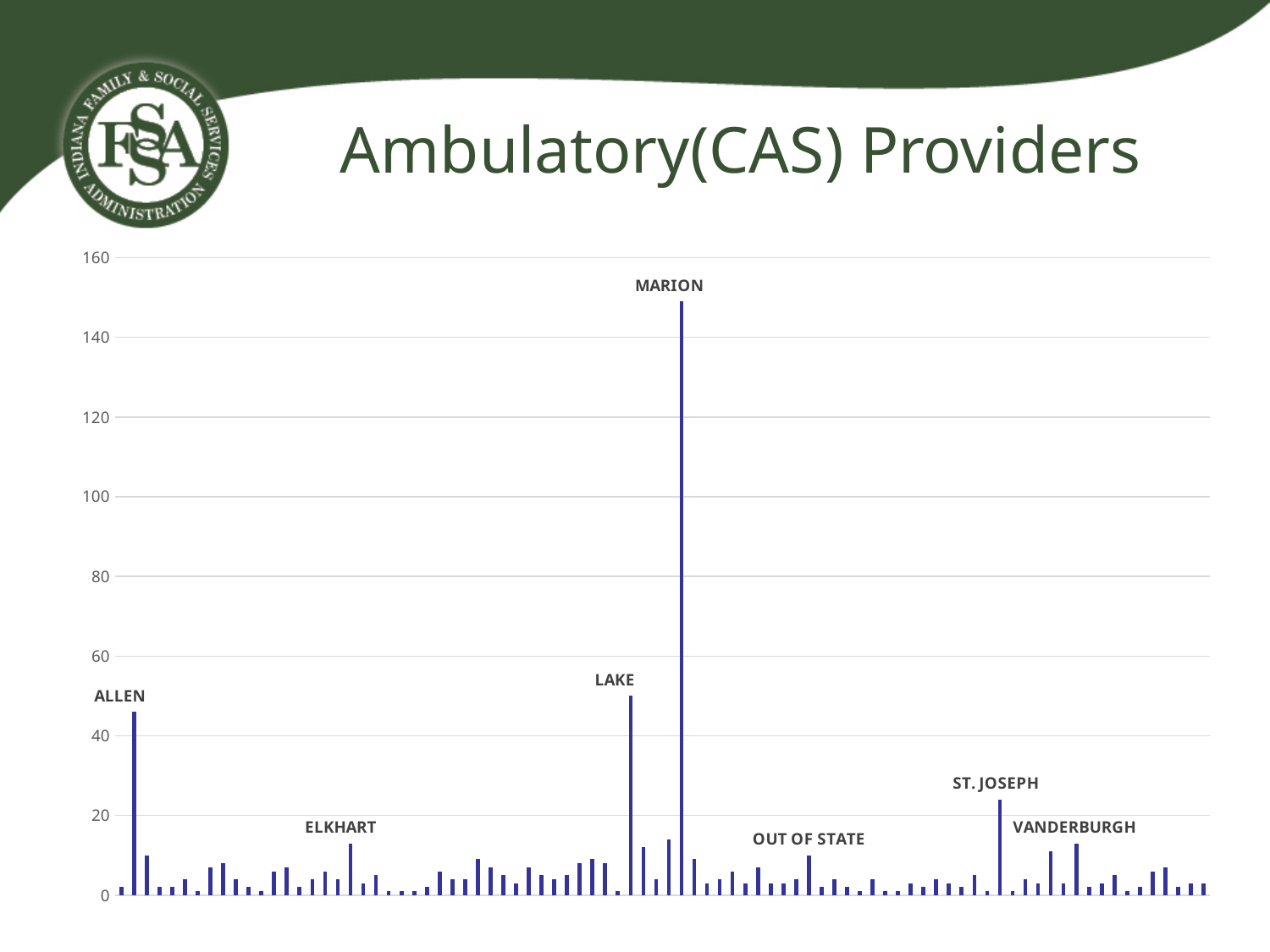
Which has more providers, ST. JOSEPH or OUT OF STATE? ST. JOSEPH What kind of chart is shown on the slide? bar chart Is the value for ALLEN greater or less than 40? greater Is the value for ELKHART greater or less than 20? less Is the value for MARION greater or less than 140? greater How many bars on the chart have a category label printed above them? 7 Which has more providers, MARION or LAKE? MARION What is the title of the slide's chart? Ambulatory(CAS) Providers Which labeled county has the highest number of Ambulatory (CAS) providers? MARION